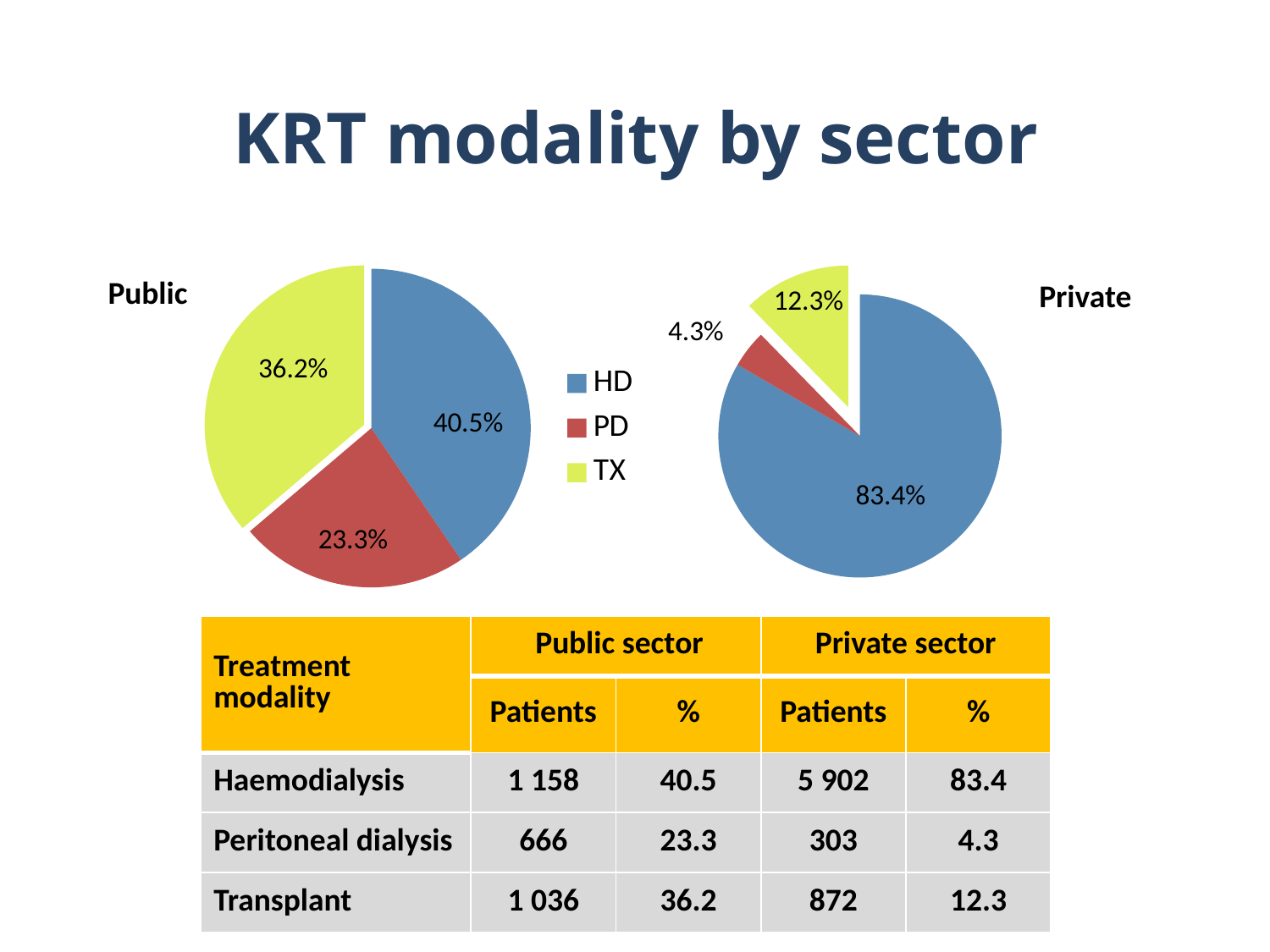
Which is larger: the TX share in the Public pie chart or the TX share in the Private pie chart? Public In the Private pie chart, which modality has the largest slice? HD In the Private pie chart, what share does PD have? 4.3% In the Public pie chart, what is the difference between the HD share and the PD share? 17.2% How many series does the legend list? 3 In the Public pie chart, what share does HD have? 40.5% In the Private pie chart, which modality has the smallest slice? PD In the Public pie chart, which modality has the smallest slice? PD In the Private pie chart, what is the difference between the HD share and the TX share? 71.1% What type of chart is used to show the Private sector data? Pie chart In the Public pie chart, what share does TX have? 36.2% How many slices does the Public pie chart have? 3